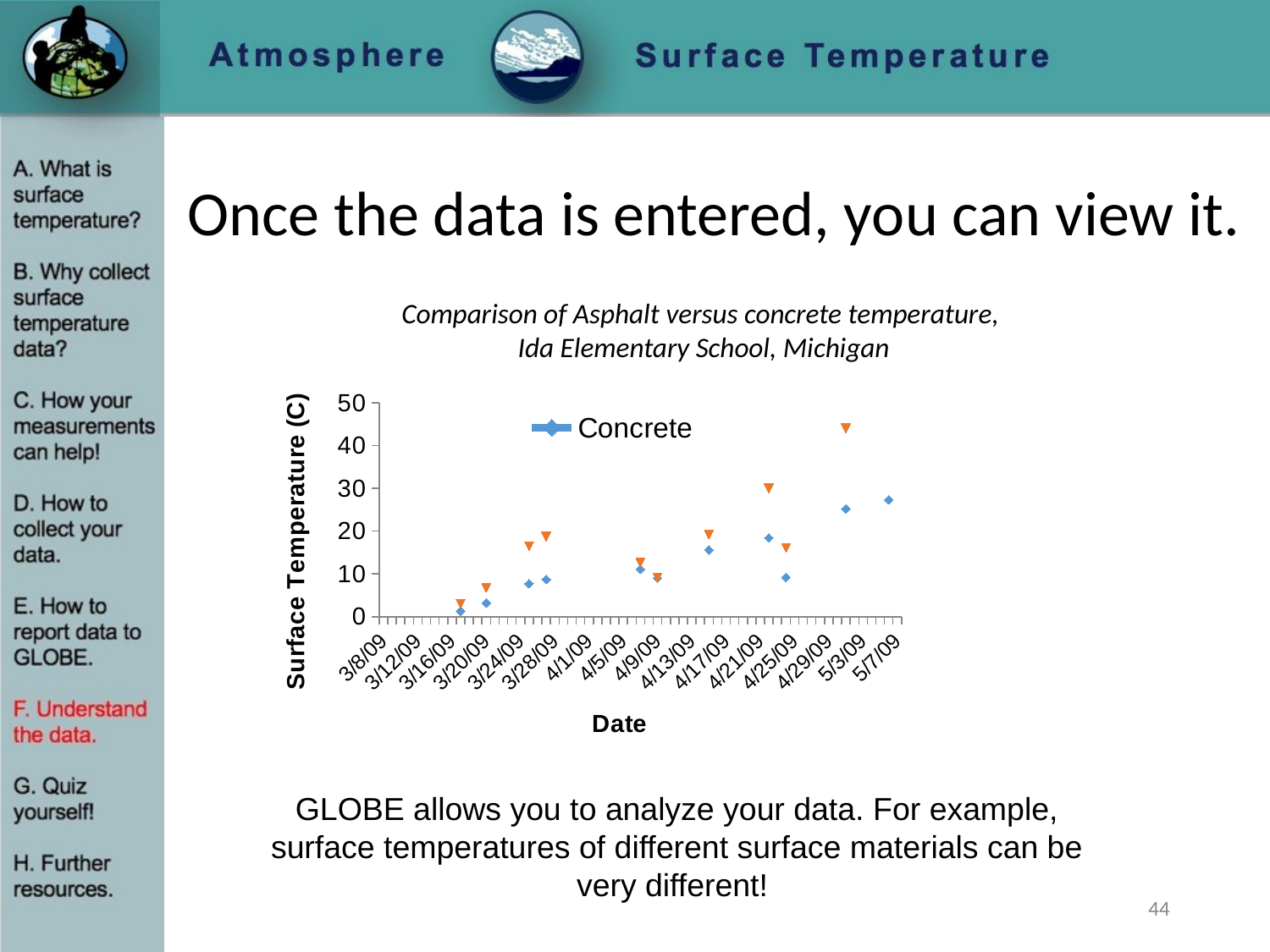
What is the title of the chart? Comparison of Asphalt versus concrete temperature, Ida Elementary School, Michigan Is the Concrete point near 4/13/09 greater or less than 10? greater Which series reaches the highest temperature on the chart, the blue Concrete series or the orange triangle series? The orange triangle series Near 5/1/09, which is higher: the orange triangle point or the blue Concrete point? The orange triangle point Is the first Concrete point (near 3/16/09) greater or less than 10? less What is the label on the vertical axis of the chart? Surface Temperature (C) What is the highest value shown on the vertical axis? 50 Is the highest orange triangle point (near 5/1/09) greater or less than 40? greater Do the Concrete temperatures generally rise or fall from March to May? Rise Which series name is shown in the chart legend? Concrete What kind of chart is shown on the slide? Scatter chart